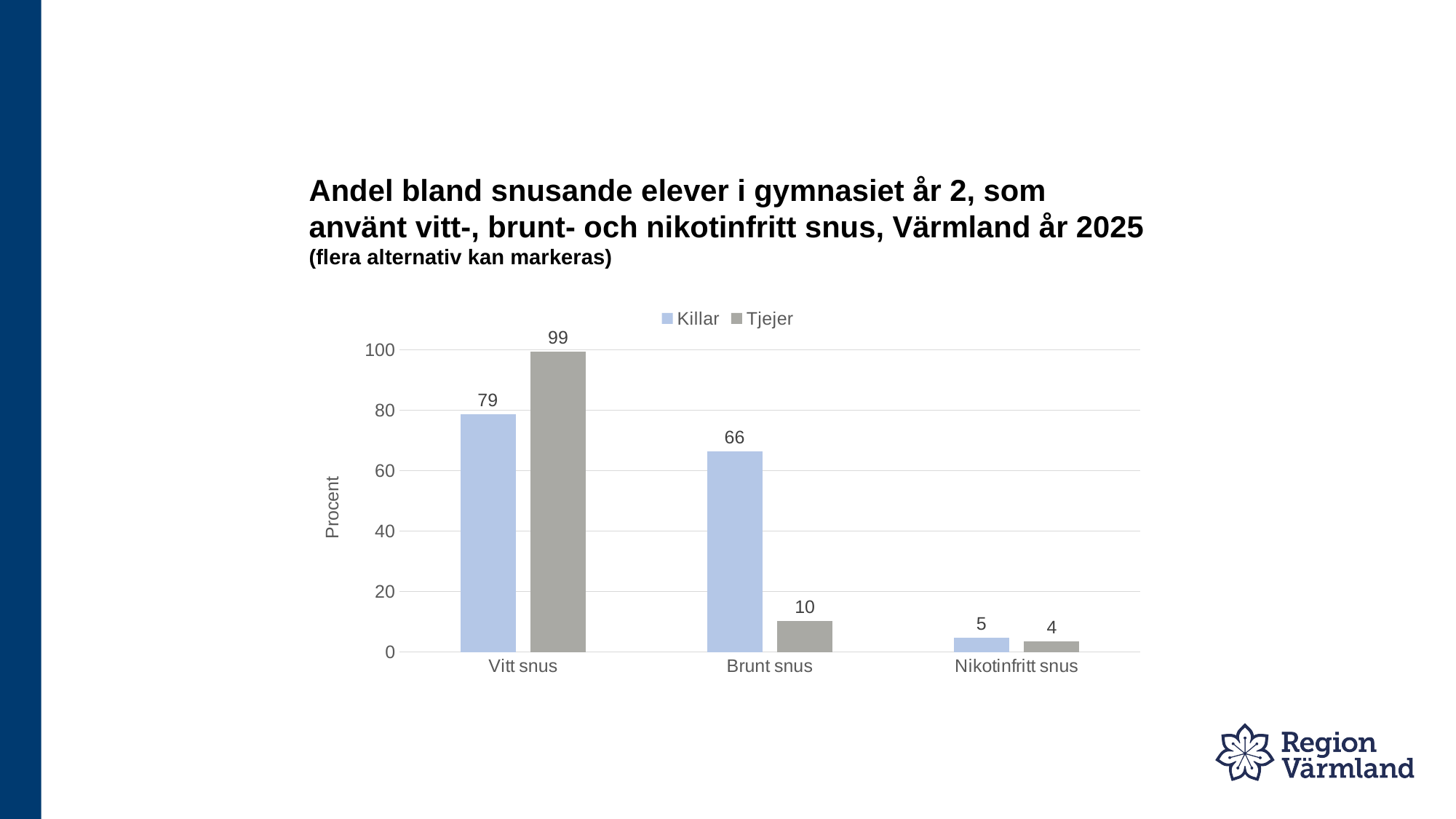
Which category has the lowest value for Killar? Nikotinfritt snus What is the difference between Killar and Tjejer for Brunt snus? 56 What is the value for Tjejer for Brunt snus? 10 What kind of chart is shown on the slide? Bar chart Which category has the highest value for Tjejer? Vitt snus What is the difference between Tjejer and Killar for Vitt snus? 20 Which is larger for Brunt snus, Killar or Tjejer? Killar What is the value for Killar for Vitt snus? 79 What is the label of the y axis? Procent How many categories are shown on the x axis? 3 How many series does the legend list? 2 What is the value for Tjejer for Nikotinfritt snus? 4